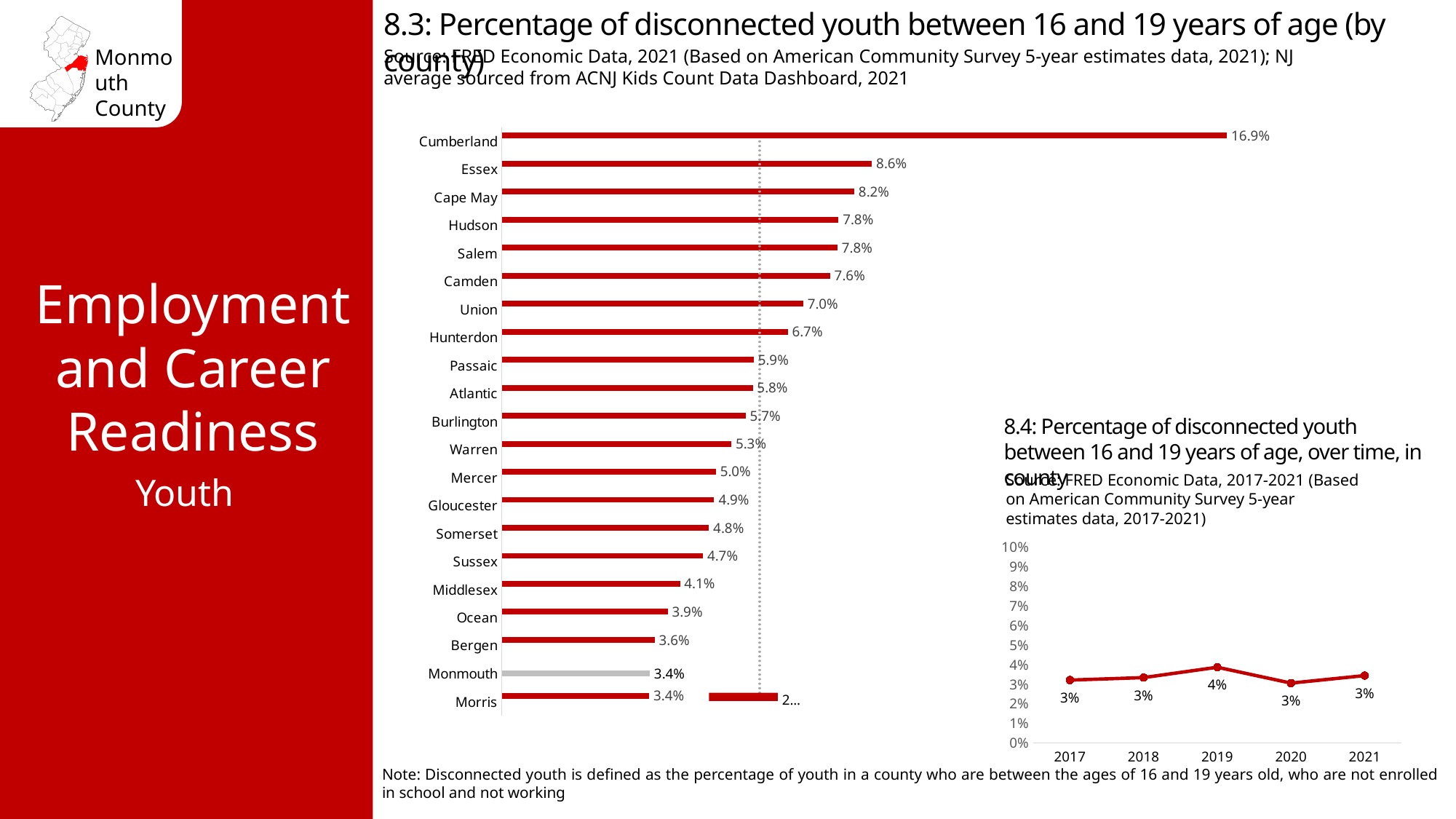
What kind of chart is chart 8.4? Line chart In chart 8.3, which has a higher value, Hudson or Camden? Hudson In chart 8.3, what is the difference between the values for Essex and Cape May? 0.4% In chart 8.4, how many years are plotted? 5 In chart 8.3, which county has the highest percentage of disconnected youth? Cumberland In chart 8.3, how many counties are shown? 21 In chart 8.3, which county's bar is shown in grey instead of red? Monmouth In chart 8.3, what is the percentage of disconnected youth for Monmouth? 3.4% In chart 8.3, what is the percentage of disconnected youth for Bergen? 3.6% In chart 8.4, what is the value for 2019? 4% In chart 8.3, what is the percentage of disconnected youth for Cumberland? 16.9% What kind of chart is chart 8.3? Bar chart